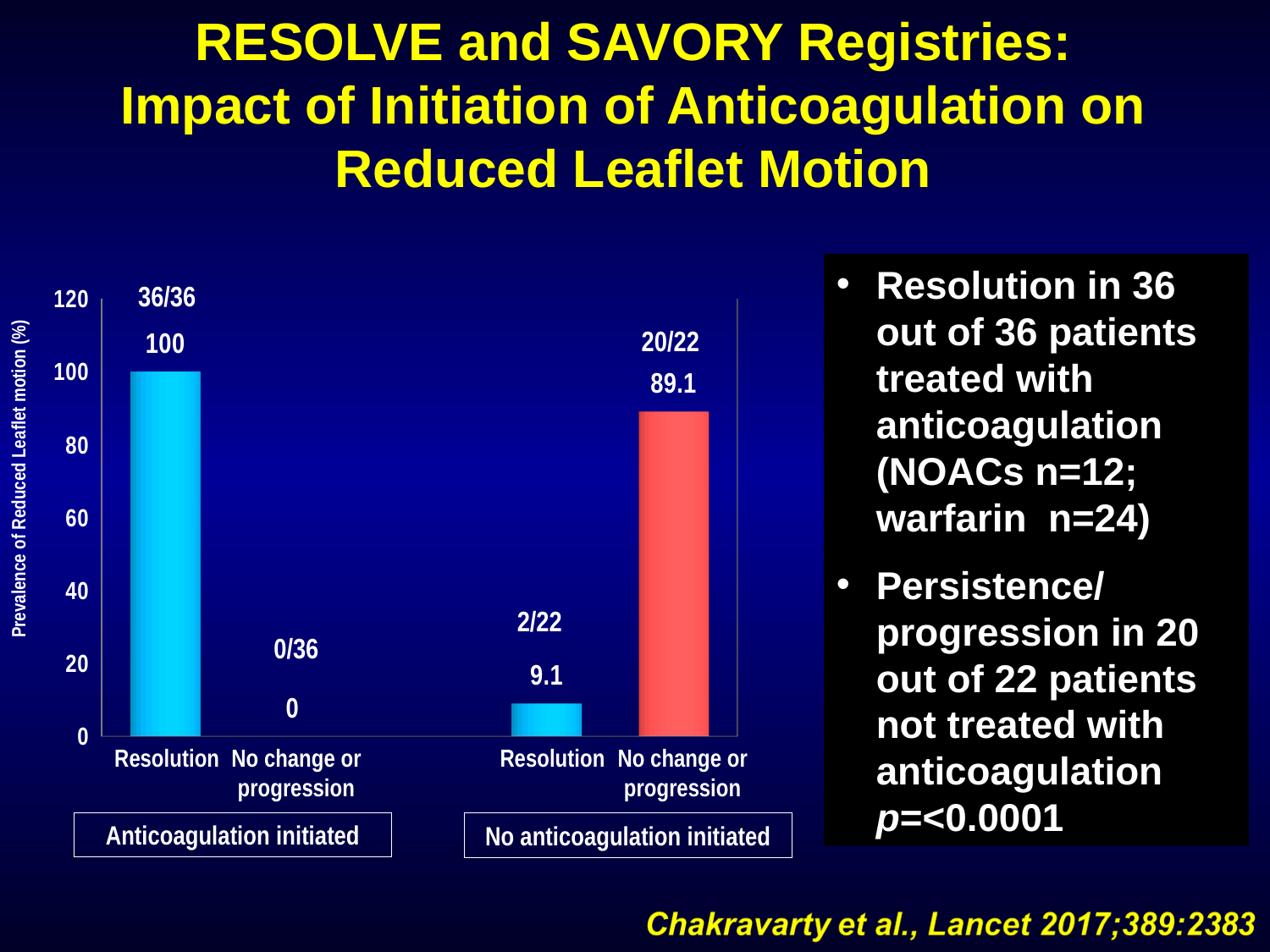
What fraction of patients is labelled above the Resolution bar in the No anticoagulation initiated group? 2/22 What is the value for Resolution in the No anticoagulation initiated group? 9.1 What is the value for Resolution in the Anticoagulation initiated group? 100 What is the value for No change or progression in the No anticoagulation initiated group? 89.1 What is the label of the y axis? Prevalence of Reduced Leaflet motion (%) Which bar has the highest value? Resolution (Anticoagulation initiated) How many bars are plotted in the chart? 3 What type of chart is shown on the slide? Bar chart Which bar has the lowest value? No change or progression (Anticoagulation initiated) What is the value for No change or progression in the Anticoagulation initiated group? 0 What is the difference between the No change or progression value in the No anticoagulation initiated group and the Resolution value in that same group? 80 Which is larger: Resolution in the Anticoagulation initiated group or No change or progression in the No anticoagulation initiated group? Resolution in the Anticoagulation initiated group